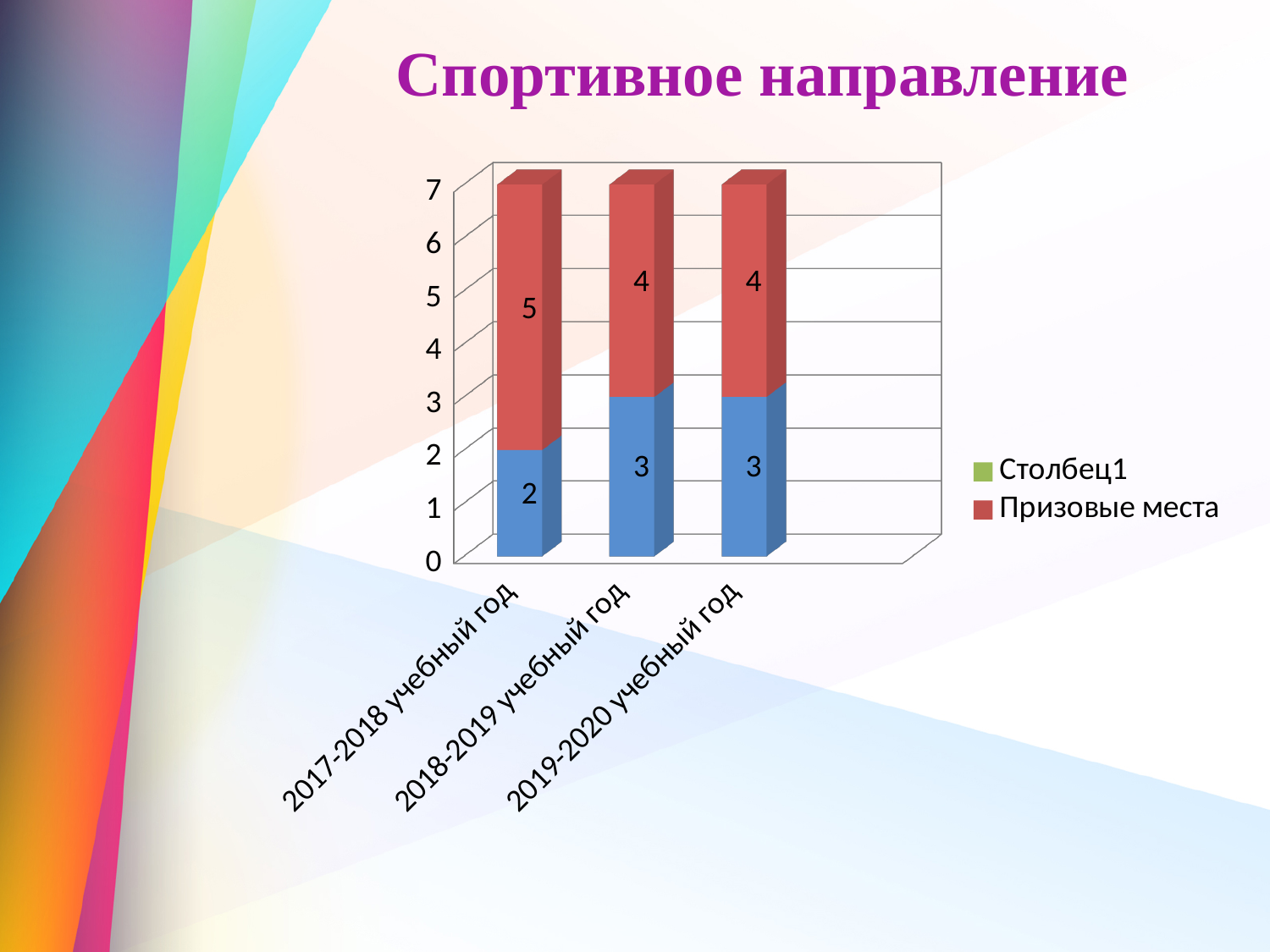
Which academic year has the highest Призовые места value? 2017-2018 учебный год What is the total height of the stacked bar for 2018-2019 учебный год? 7 What is the value of the blue bottom segment for 2017-2018 учебный год? 2 Which academic year has the lowest value for the blue bottom segment? 2017-2018 учебный год What type of chart is shown on the slide? Stacked bar chart What is the value of the Призовые места segment for 2017-2018 учебный год? 5 What is the difference between the Призовые места values for 2017-2018 учебный год and 2018-2019 учебный год? 1 What is the value of the Призовые места segment for 2018-2019 учебный год? 4 What is the value of the blue bottom segment for 2019-2020 учебный год? 3 Which is larger: the blue bottom segment for 2018-2019 учебный год or for 2017-2018 учебный год? 2018-2019 учебный год How many academic years are shown on the x axis? 3 How many series does the legend list? 2